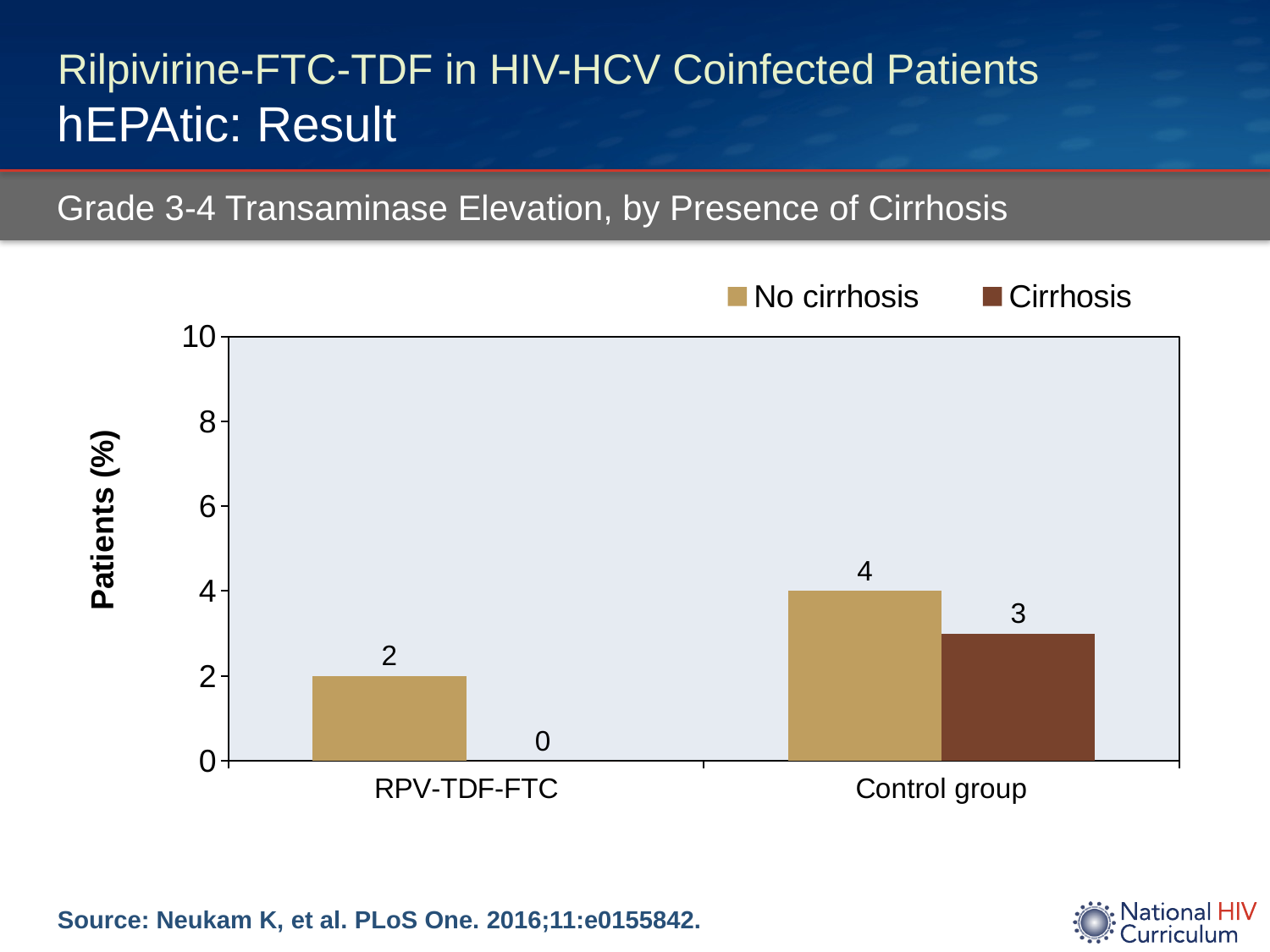
What is the difference between the No cirrhosis values for the Control group and RPV-TDF-FTC? 2 How many groups are shown on the x axis? 2 What is the value for No cirrhosis in the RPV-TDF-FTC group? 2 Which group has the lowest value for Cirrhosis? RPV-TDF-FTC What kind of chart is shown on the slide? Bar chart Which group has the highest value for No cirrhosis? Control group What is the label of the y axis? Patients (%) In the Control group, which is larger: the No cirrhosis value or the Cirrhosis value? No cirrhosis How many series does the legend list? 2 What is the value for No cirrhosis in the Control group? 4 What is the value for Cirrhosis in the RPV-TDF-FTC group? 0 What is the value for Cirrhosis in the Control group? 3